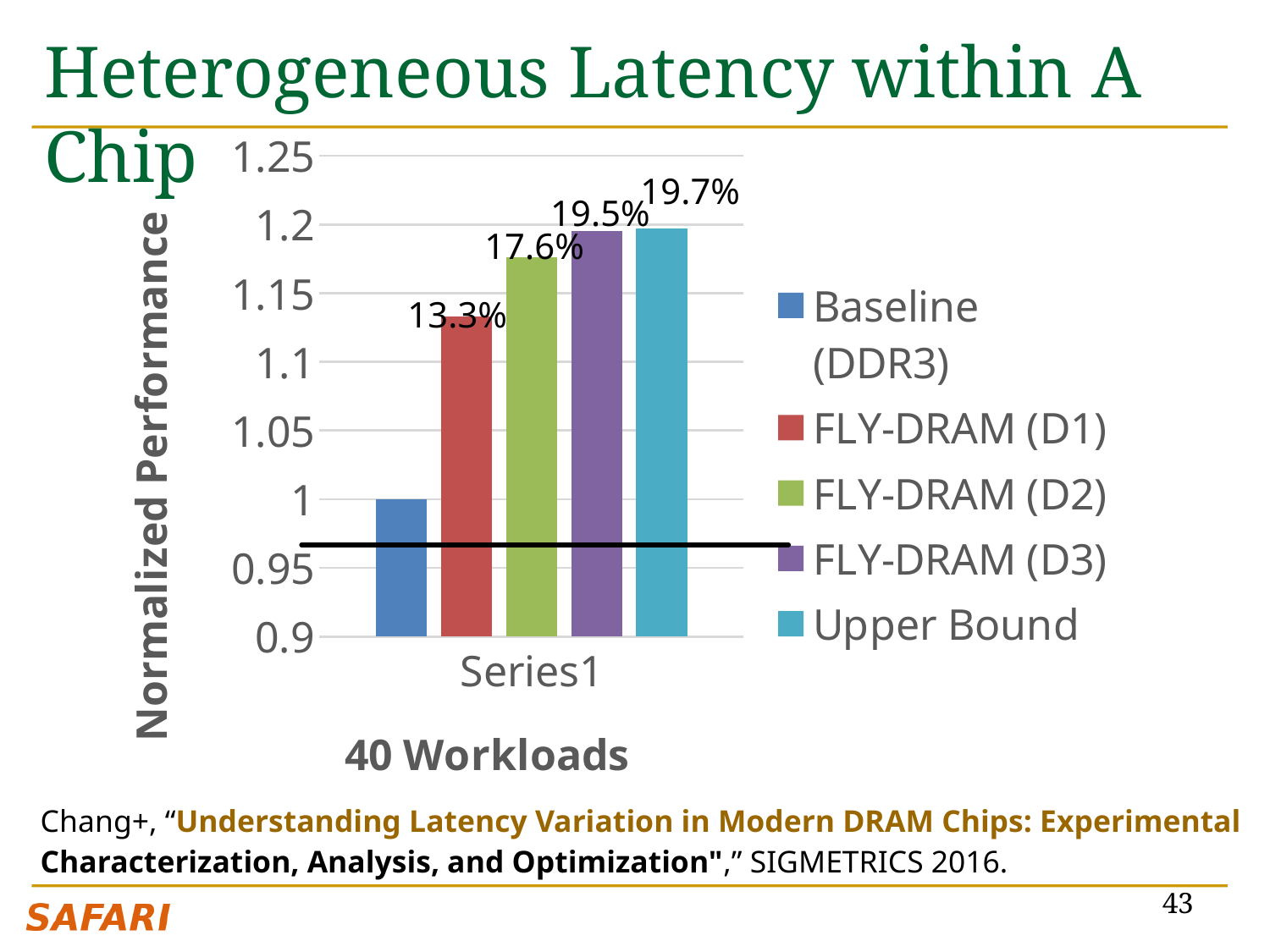
What is the title of the y axis? Normalized Performance What is the data label shown above the FLY-DRAM (D3) bar? 19.5% What is the data label shown above the Upper Bound bar? 19.7% What normalized performance value does the Baseline (DDR3) bar reach on the y axis? 1 Which series has the shortest bar? Baseline (DDR3) How many series does the legend list? 5 Which series has the tallest bar? Upper Bound What is the data label shown above the FLY-DRAM (D1) bar? 13.3% Is the value for FLY-DRAM (D1) greater or less than 1.1? greater What kind of chart is shown on the slide? bar chart What is the data label shown above the FLY-DRAM (D2) bar? 17.6% Which bar is taller, FLY-DRAM (D1) or FLY-DRAM (D2)? FLY-DRAM (D2)